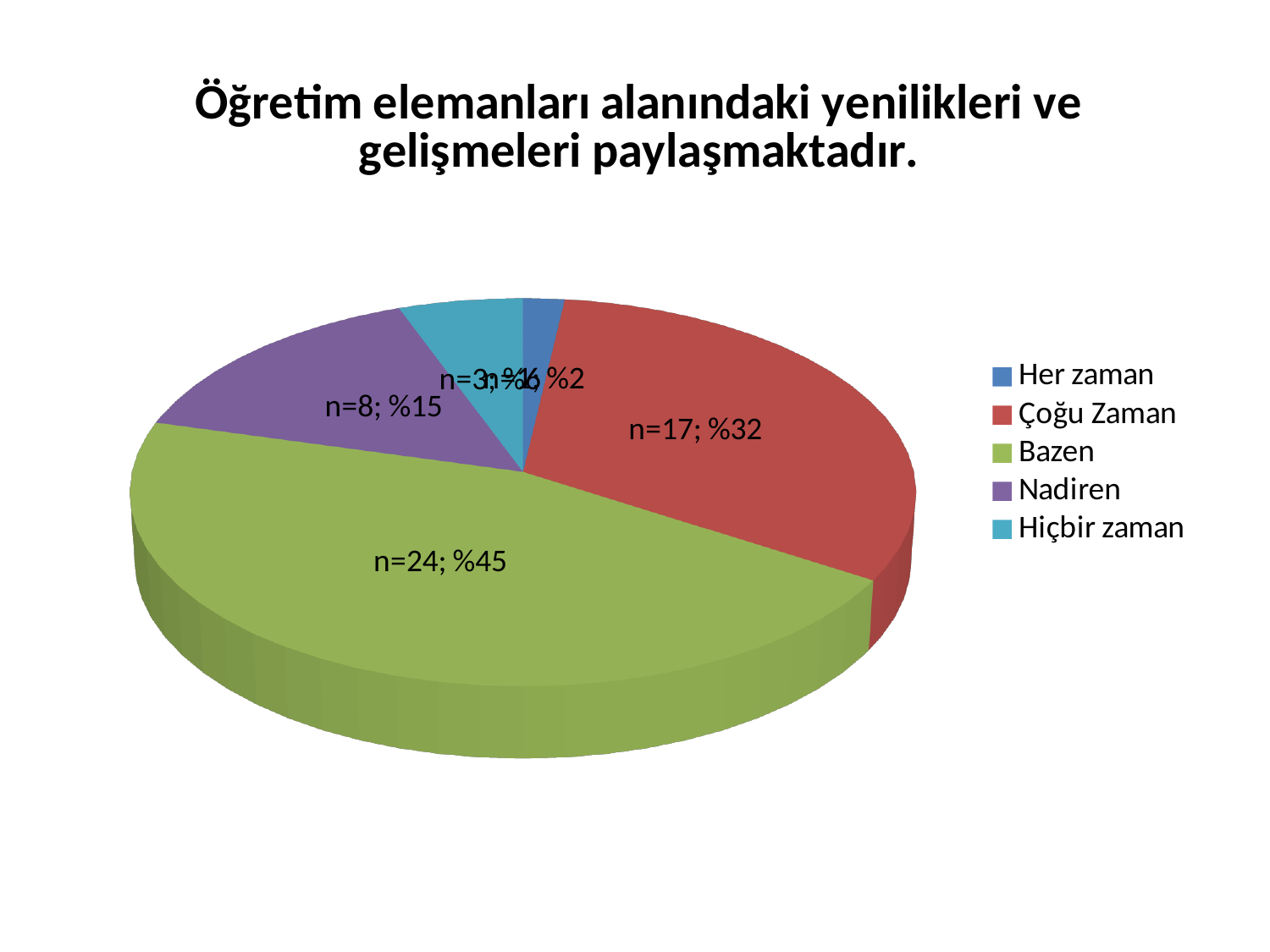
Which category has the largest slice of the pie chart? Bazen What percentage share does the Bazen slice have? %45 What colour is the Bazen slice in the pie chart? green What percentage share does the Çoğu Zaman slice have? %32 What is the n value shown for the Bazen slice? n=24 How many categories does the legend of the pie chart list? 5 What is the n value shown for the Çoğu Zaman slice? n=17 What is the difference in n between the Bazen and Çoğu Zaman slices? 7 Which category has the smallest slice of the pie chart? Her zaman Which slice is larger, Çoğu Zaman or Nadiren? Çoğu Zaman What kind of chart is shown on the slide? pie chart What is the n value shown for the Nadiren slice? n=8